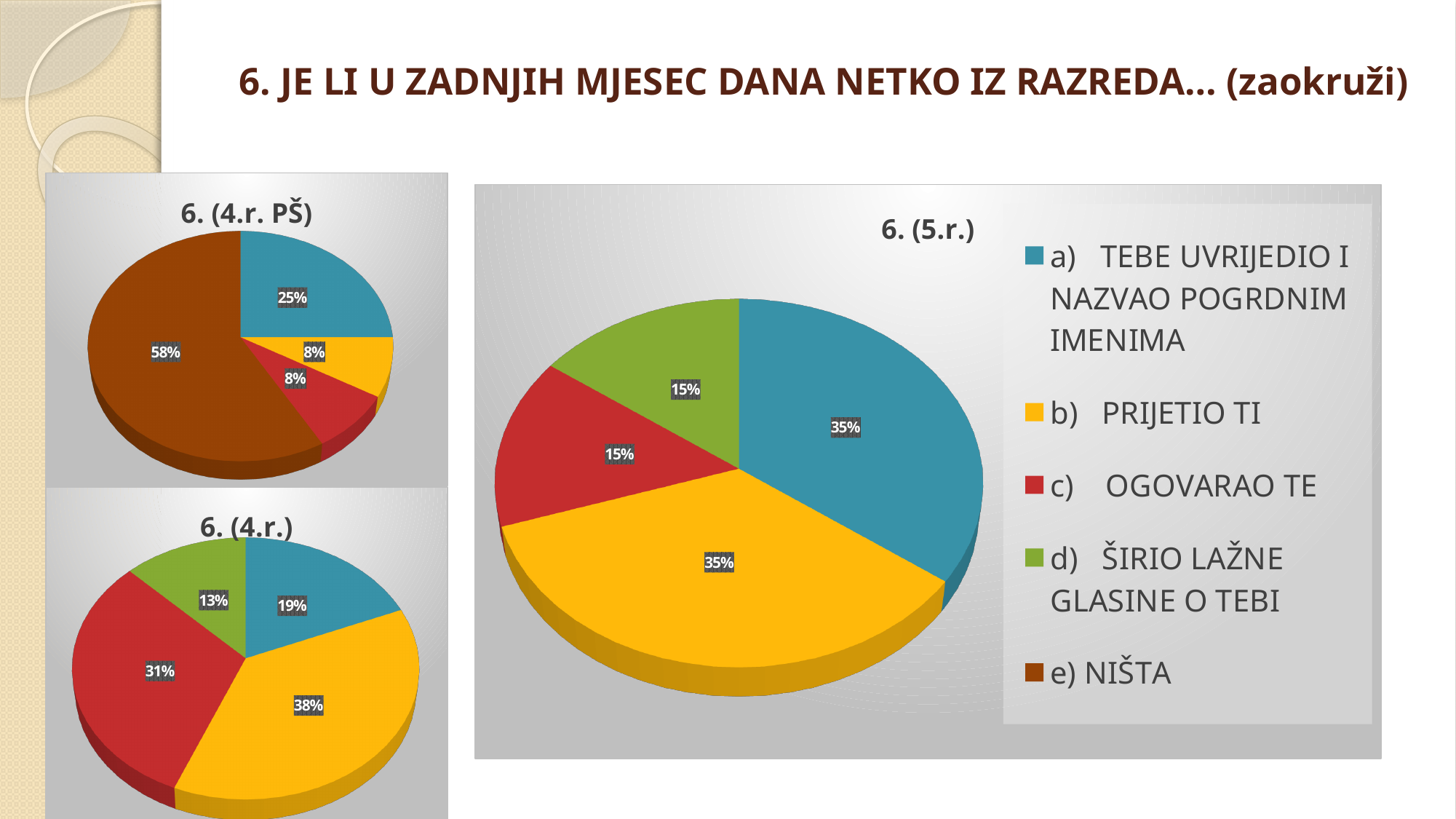
How many slices does the chart titled "6. (5.r.)" have? 4 In the chart titled "6. (4.r.)", which is larger, the blue slice or the red slice? the red slice In the chart titled "6. (4.r. PŠ)", what percentage is shown on the brown slice? 58% In the chart titled "6. (4.r. PŠ)", what percentage is shown on the blue slice? 25% In the chart titled "6. (5.r.)", what percentage is shown for "a) TEBE UVRIJEDIO I NAZVAO POGRDNIM IMENIMA"? 35% In the chart titled "6. (5.r.)", what percentage is shown for "d) ŠIRIO LAŽNE GLASINE O TEBI"? 15% In the chart titled "6. (4.r.)", which slice has the smallest share? the green slice (13%) In the chart titled "6. (4.r. PŠ)", which slice has the largest share? the brown slice (58%) How many entries does the legend on the right of the slide list? 5 In the chart titled "6. (4.r.)", what is the difference between the yellow slice and the red slice? 7% In the chart titled "6. (4.r.)", what percentage is shown on the yellow slice? 38% In the chart titled "6. (5.r.)", what percentage is shown for "c) OGOVARAO TE"? 15%